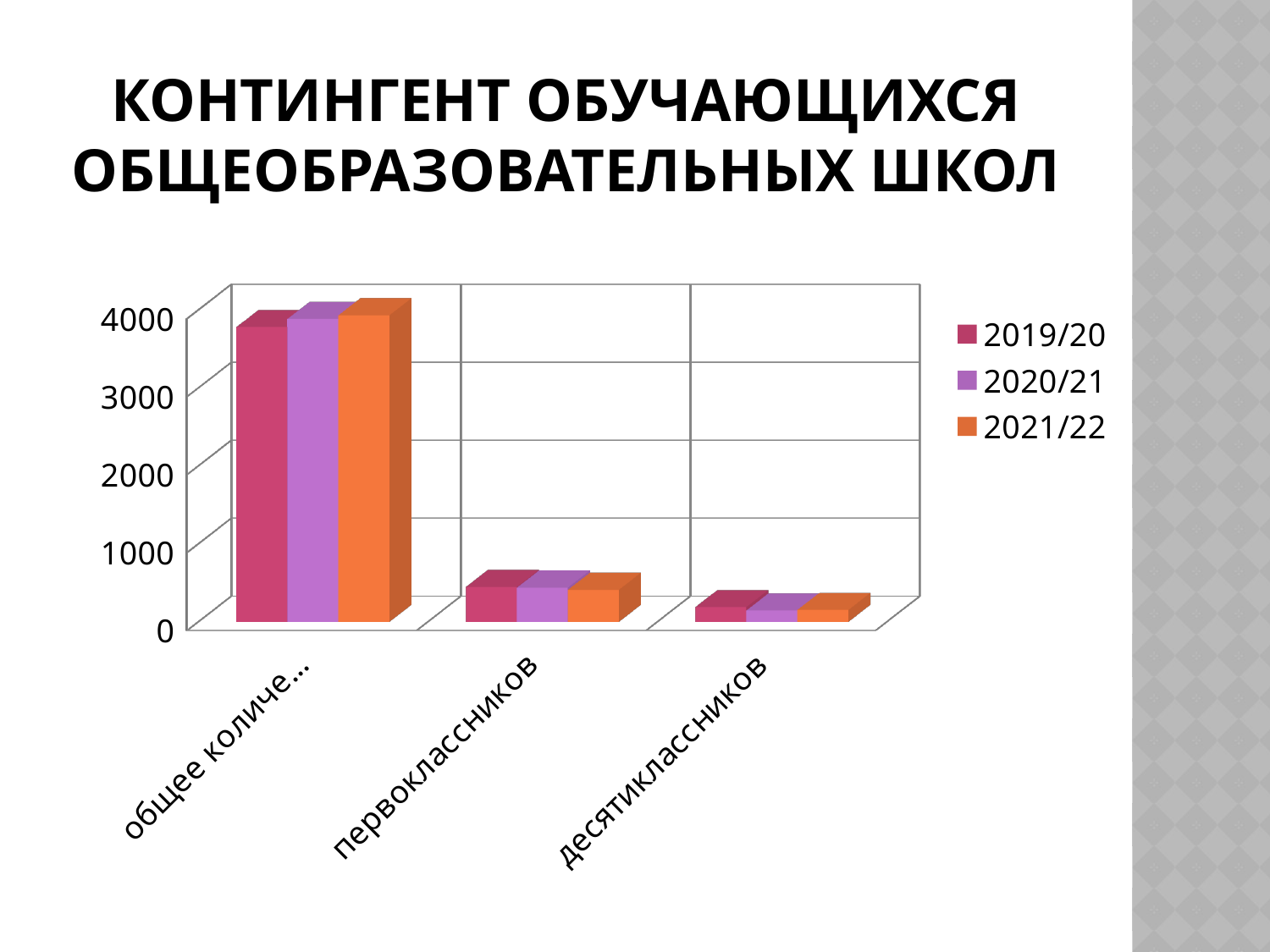
Is the value for десятиклассников in 2019/20 greater or less than 1000? less What kind of chart is shown on the slide? bar chart For 2021/22, which is larger: первоклассников or десятиклассников? первоклассников Which category has the highest values across all series? the first (leftmost) category How many categories are shown on the x axis? 3 Is the 2020/21 value for the leftmost category greater or less than 3000? greater Which category has the lowest values across all series? десятиклассников Is the value for первоклассников in 2021/22 greater or less than 1000? less What is the title of the slide containing the chart? КОНТИНГЕНТ ОБУЧАЮЩИХСЯ ОБЩЕОБРАЗОВАТЕЛЬНЫХ ШКОЛ Do the values rise or fall moving from left to right along the x axis? fall Which series are listed in the legend? 2019/20, 2020/21, 2021/22 How many series does the legend list? 3